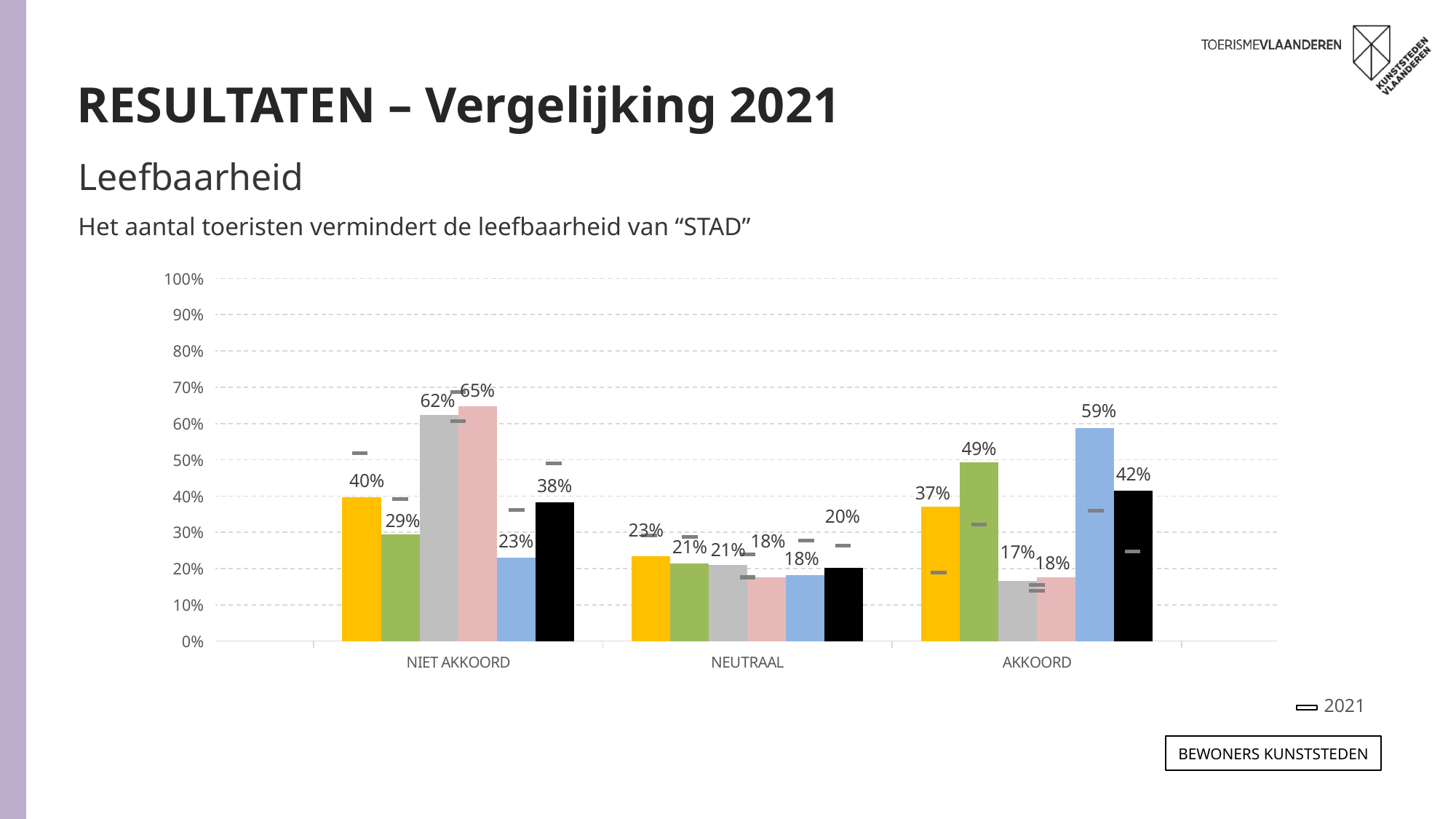
How many categories are shown on the x axis? 3 What is the value of the black bar in the AKKOORD category? 42% What is the value of the yellow bar in the NEUTRAAL category? 23% Is the 2021 marker for the blue bar in the AKKOORD category greater or less than 30%? greater What is the value of the pink bar in the NIET AKKOORD category? 65% Which coloured bar is the highest in the NIET AKKOORD category? pink How many entries does the legend list? 1 Which is larger in the NIET AKKOORD category: the grey bar or the black bar? grey bar What is the difference between the green bar and the yellow bar in the AKKOORD category? 12% Which coloured bar is the lowest in the AKKOORD category? grey What is the value of the blue bar in the AKKOORD category? 59% What kind of chart is shown on the slide? bar chart